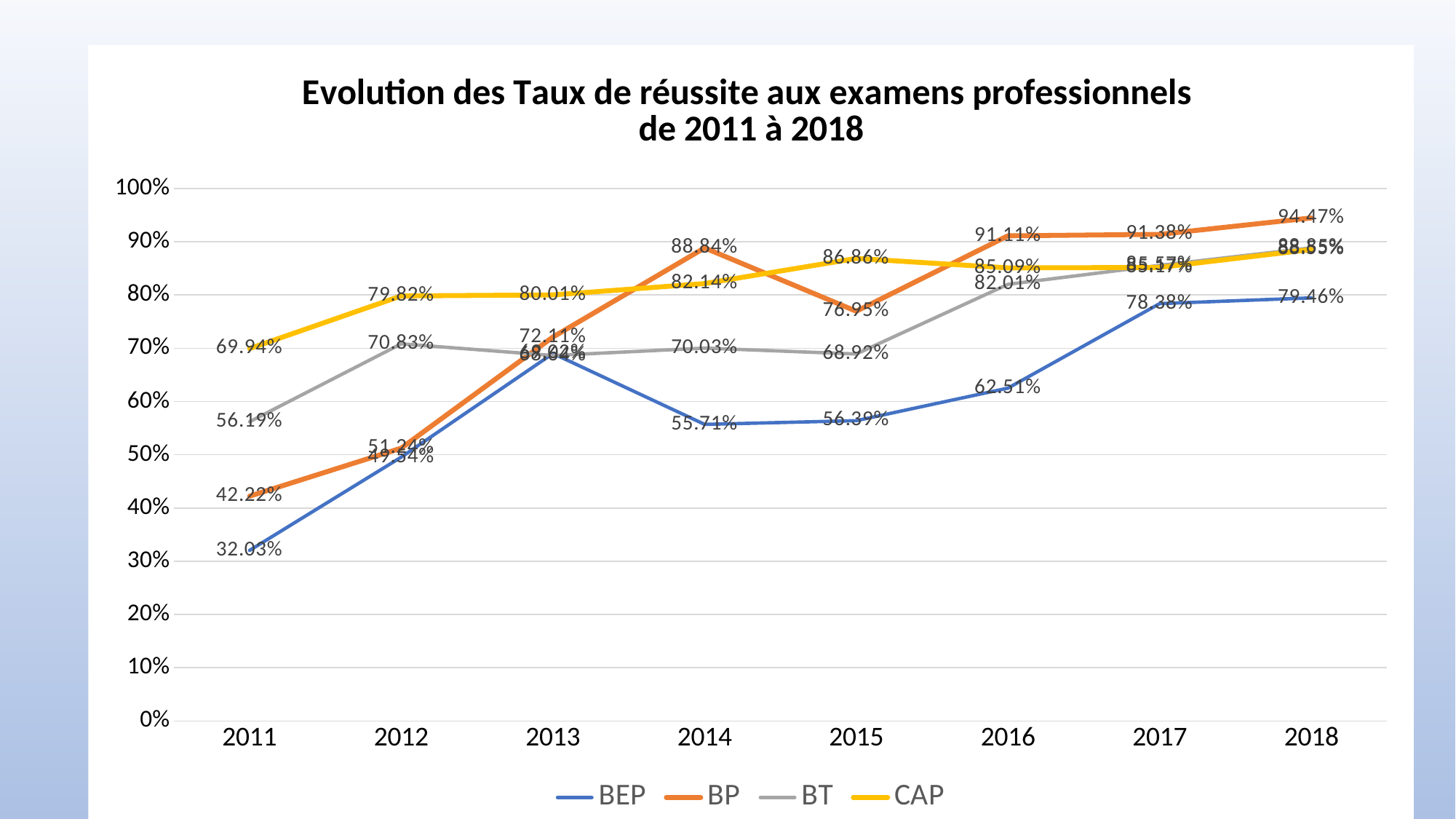
What is the BEP success rate in 2011? 32.03% What is the BP success rate in 2014? 88.84% What type of chart is shown on the slide? Line chart What is the CAP success rate in 2015? 86.86% Is the BEP value for 2014 greater or less than 60%? less How many years are shown on the x axis? 8 How many series does the legend list? 4 Which series has the higher value in 2014, CAP or BT? CAP What is the BT success rate in 2012? 70.83% In which year is the BP success rate highest? 2018 In which year is the BEP success rate lowest? 2011 What is the difference between the BP success rate in 2014 and in 2015? 11.89 percentage points